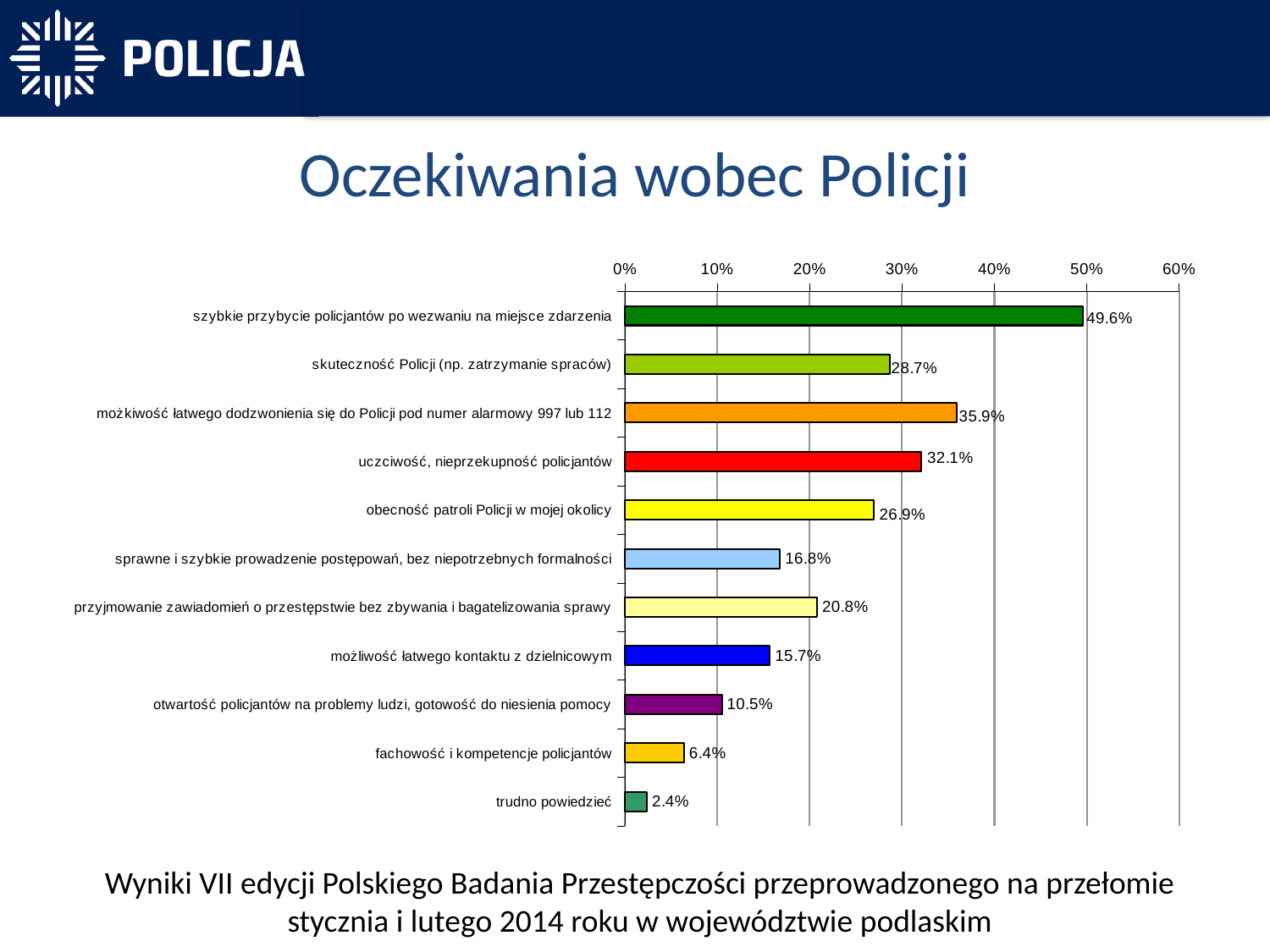
Which is larger: the value for "obecność patroli Policji w mojej okolicy" or for "przyjmowanie zawiadomień o przestępstwie bez zbywania i bagatelizowania sprawy"? obecność patroli Policji w mojej okolicy Is the value for "możliwość łatwego kontaktu z dzielnicowym" greater or less than 20%? less What is the value for "uczciwość, nieprzekupność policjantów"? 32.1% What is the value for "fachowość i kompetencje policjantów"? 6.4% How many categories are shown in the chart? 11 What is the title of the slide's chart? Oczekiwania wobec Policji What kind of chart is shown on the slide? bar chart What is the difference between the values for "możkiwość łatwego dodzwonienia się do Policji pod numer alarmowy 997 lub 112" and "skuteczność Policji (np. zatrzymanie spraców)"? 7.2% What is the value for "otwartość policjantów na problemy ludzi, gotowość do niesienia pomocy"? 10.5% Which category has the lowest value? trudno powiedzieć What is the value for "szybkie przybycie policjantów po wezwaniu na miejsce zdarzenia"? 49.6% Which category has the highest value? szybkie przybycie policjantów po wezwaniu na miejsce zdarzenia